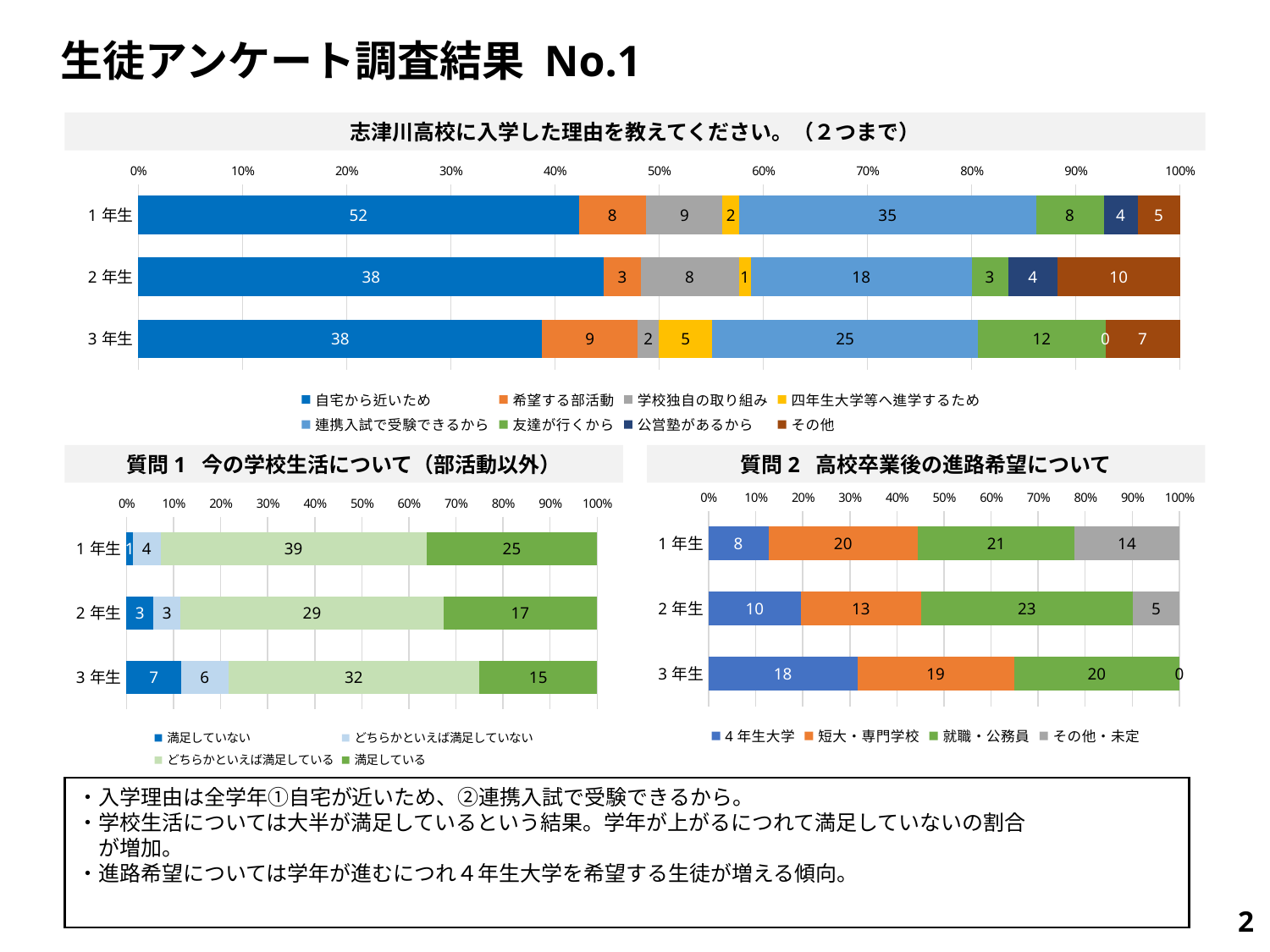
In the chart '質問２ 高校卒業後の進路希望について', which is larger for 2年生: 短大・専門学校 or 就職・公務員? 就職・公務員 In the chart '質問１ 今の学校生活について（部活動以外）', what is the value for 満足している for 2年生? 17 In the top chart '志津川高校に入学した理由を教えてください。', what is the value for 自宅から近いため for 1年生? 52 In the chart '質問２ 高校卒業後の進路希望について', what is the total of the stacked bar for 3年生? 57 In the chart '質問１ 今の学校生活について（部活動以外）', which grade has the highest value for 満足していない? 3年生 In the chart '質問２ 高校卒業後の進路希望について', what is the value for 4年生大学 for 3年生? 18 In the top chart '志津川高校に入学した理由を教えてください。', which grade has the highest value for その他? 2年生 In the top chart '志津川高校に入学した理由を教えてください。', what is the difference between the 自宅から近いため values for 1年生 and 2年生? 14 In the top chart '志津川高校に入学した理由を教えてください。', how many series does the legend list? 8 In the top chart '志津川高校に入学した理由を教えてください。', what is the value for 連携入試で受験できるから for 3年生? 25 In the chart '質問１ 今の学校生活について（部活動以外）', what is the total of the stacked bar for 1年生? 69 What kind of chart is '質問２ 高校卒業後の進路希望について'? Stacked bar chart